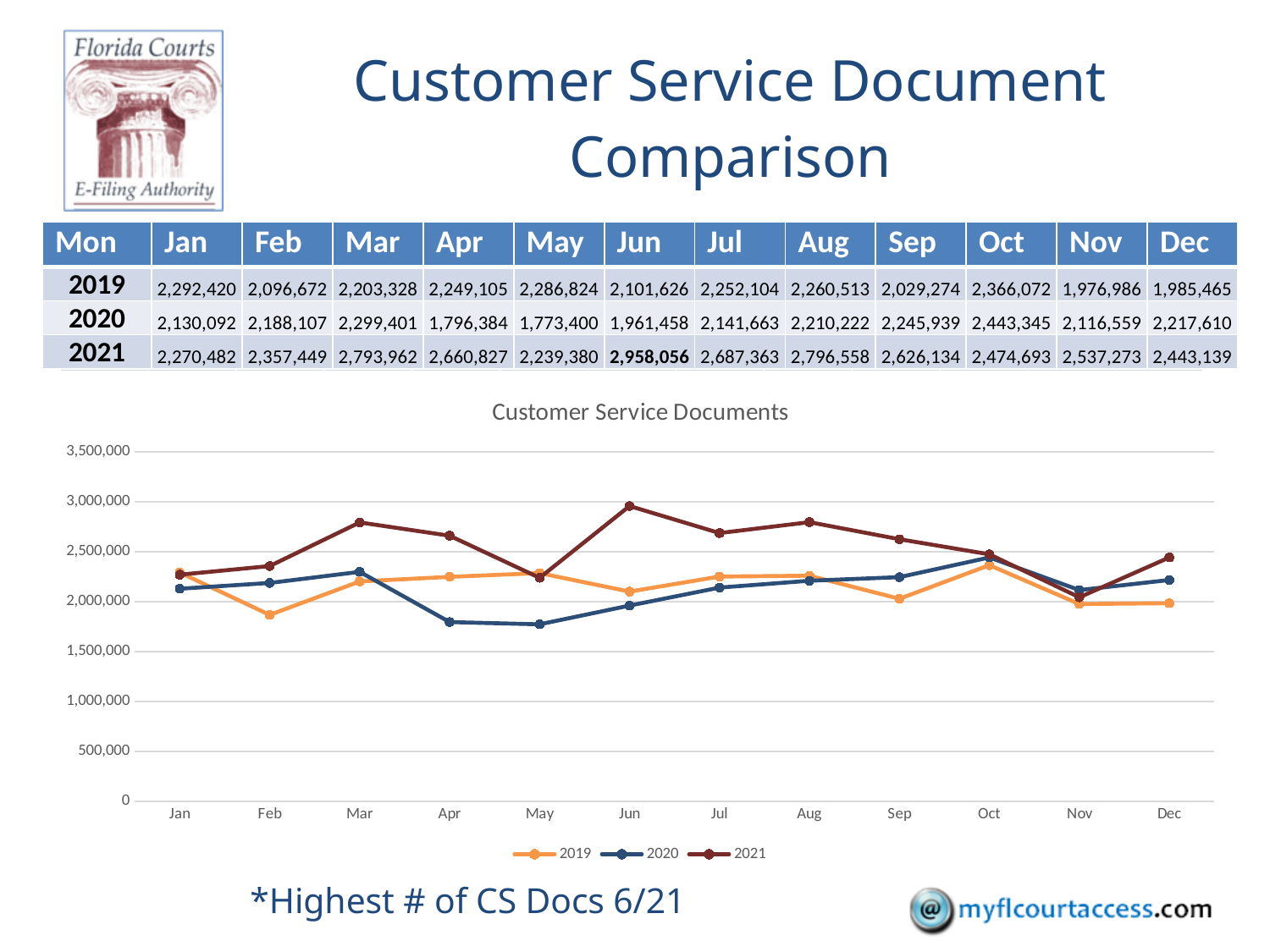
How many series does the chart legend list? 3 Which is larger in March: the 2021 value or the 2019 value? 2021 Is the value for 2021 in June greater or less than 2,500,000? greater What is the difference between the 2021 and 2020 values in June? 996,598 What is the value for 2021 in June? 2,958,056 What is the value for 2019 in November? 1,976,986 What is the title of the chart? Customer Service Documents How many months are plotted along the x axis of the chart? 12 In which month does the 2021 series reach its highest value? Jun In which month does the 2019 series reach its highest value? Oct What kind of chart is shown on the slide? line chart Does the 2020 series rise or fall from March to May? fall